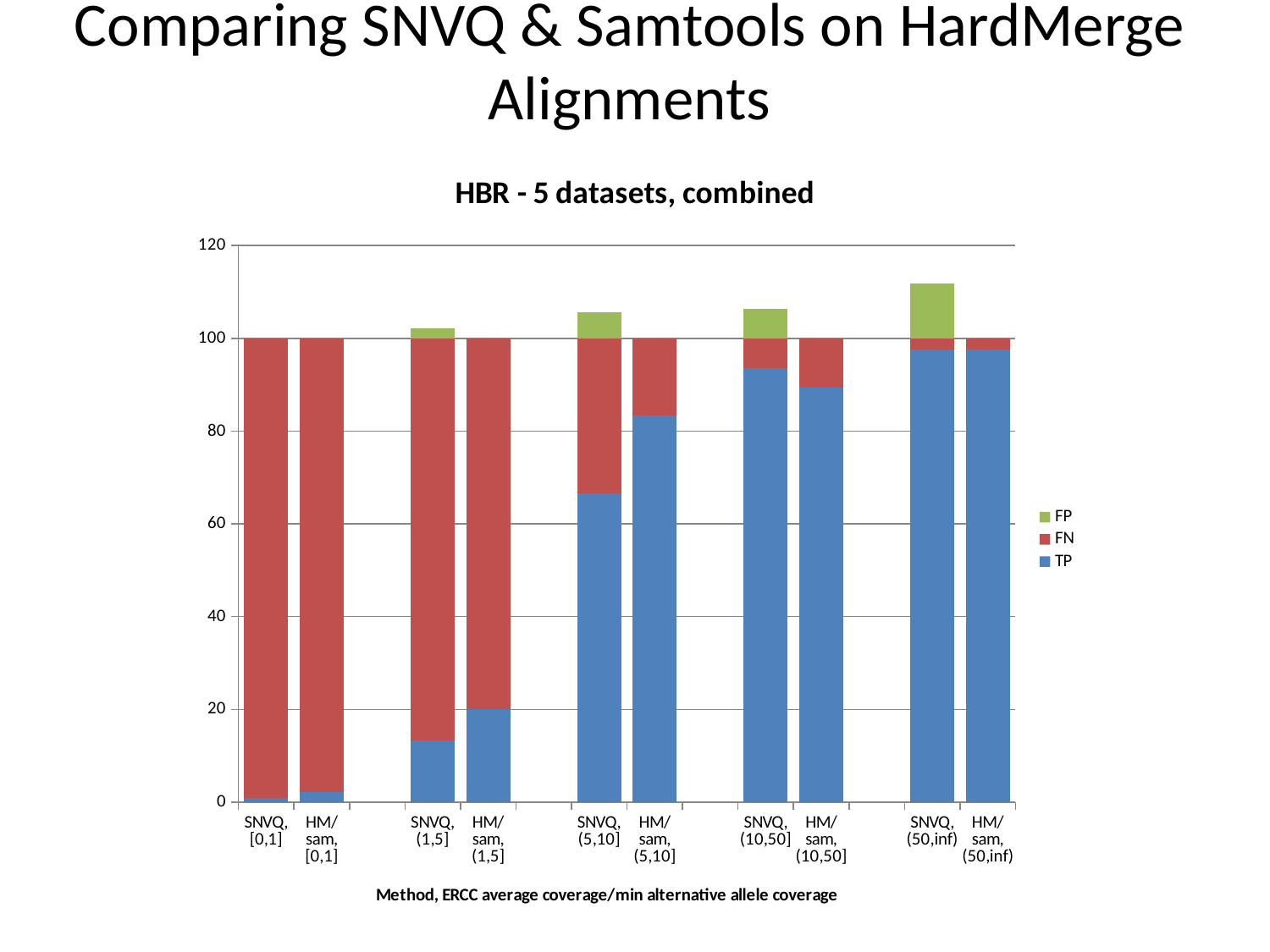
Is the total height of the SNVQ, (50,inf) bar greater or less than 100? greater Which bar has the greatest total height? SNVQ, (50,inf) Do the TP values for the SNVQ bars rise or fall as coverage increases along the x axis? rise What is the title of the chart? HBR - 5 datasets, combined Which category has the largest FP segment? SNVQ, (50,inf) Which has the larger TP value: SNVQ, (5,10] or HM/sam, (5,10]? HM/sam, (5,10] Is the TP value for SNVQ, (5,10] greater or less than 60? greater How many series does the legend list? 3 What kind of chart is shown on the slide? stacked bar chart Is the TP value for HM/sam, (1,5] greater or less than 40? less How many bars (categories) are plotted on the chart? 10 Which series is shown in green in the legend? FP